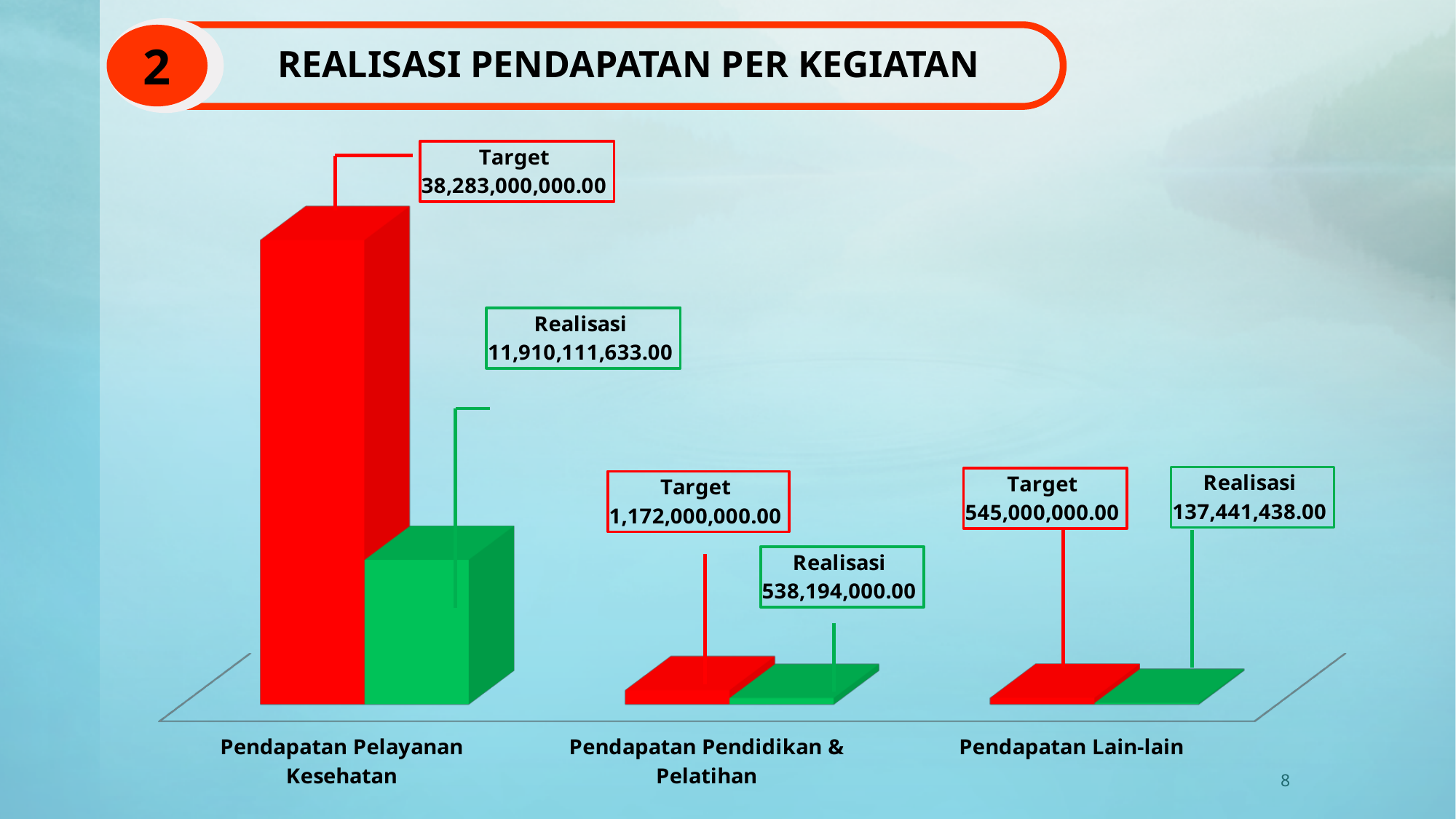
What is the Target value for Pendapatan Lain-lain? 545,000,000.00 What is the Realisasi value for Pendapatan Pendidikan & Pelatihan? 538,194,000.00 What is the difference between the Target and Realisasi values for Pendapatan Pendidikan & Pelatihan? 633,806,000.00 What is the Realisasi value for Pendapatan Pelayanan Kesehatan? 11,910,111,633.00 What is the Target value for Pendapatan Pendidikan & Pelatihan? 1,172,000,000.00 What is the Realisasi value for Pendapatan Lain-lain? 137,441,438.00 Which category has the highest Target value? Pendapatan Pelayanan Kesehatan How many categories are shown on the x axis of the chart? 3 What is the Target value for Pendapatan Pelayanan Kesehatan? 38,283,000,000.00 Which is larger for Pendapatan Lain-lain, the Target or the Realisasi value? Target What type of chart is shown on the slide? Bar chart Which category has the lowest Realisasi value? Pendapatan Lain-lain